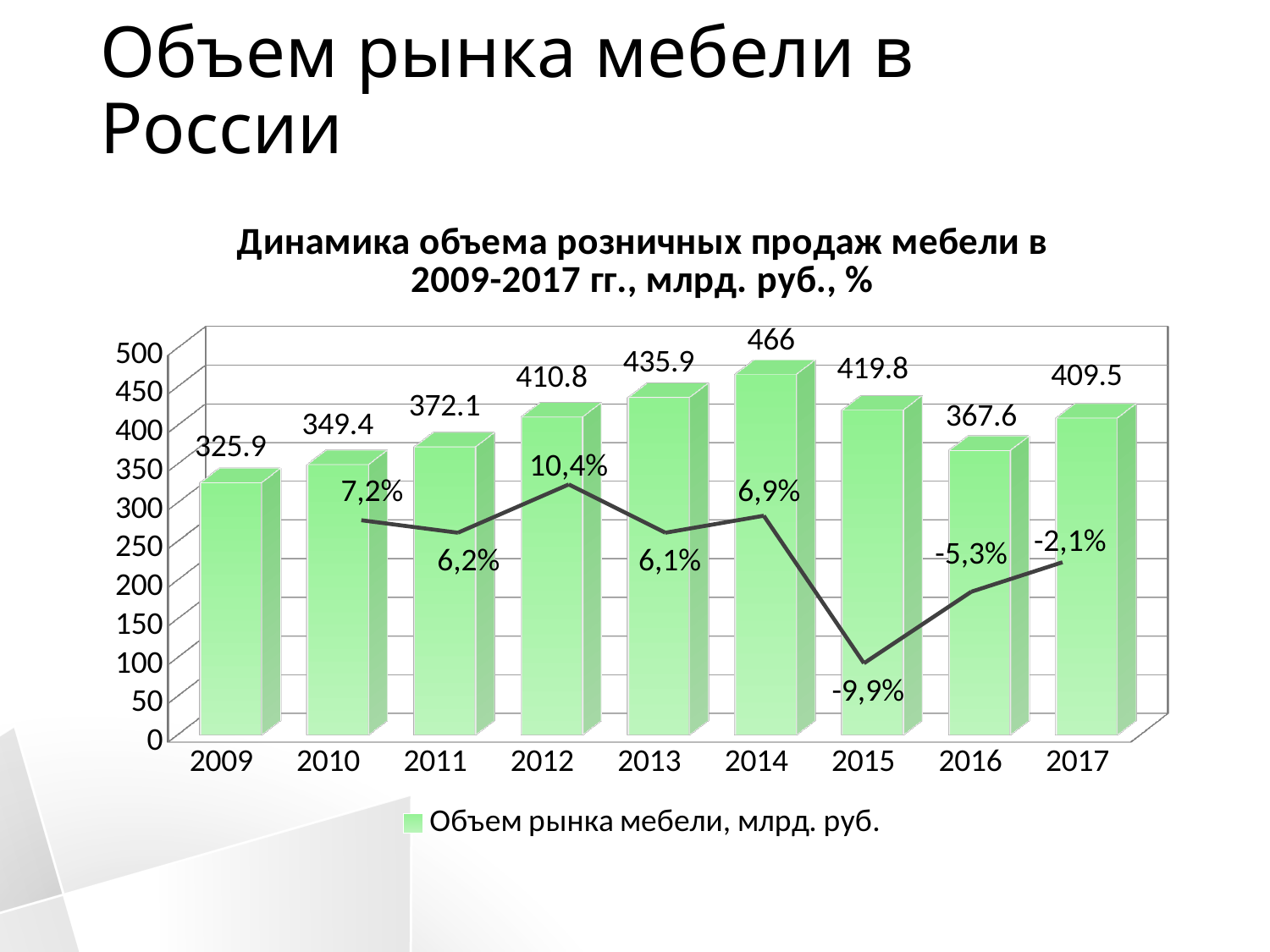
How many series does the legend list? 1 What is the furniture market volume for 2012? 410.8 What growth rate is shown on the line for 2015? -9,9% What is the difference between the market volume in 2014 and in 2015? 46.2 Which year has the lowest furniture market volume? 2009 What is the title of the chart? Динамика объема розничных продаж мебели в 2009-2017 гг., млрд. руб., % What is the furniture market volume for 2017? 409.5 Do the bar values rise or fall from 2009 to 2014? rise How many years are shown on the x axis? 9 Which year has the highest furniture market volume? 2014 Which year has the larger market volume, 2013 or 2016? 2013 What growth rate is shown on the line for 2012? 10,4%